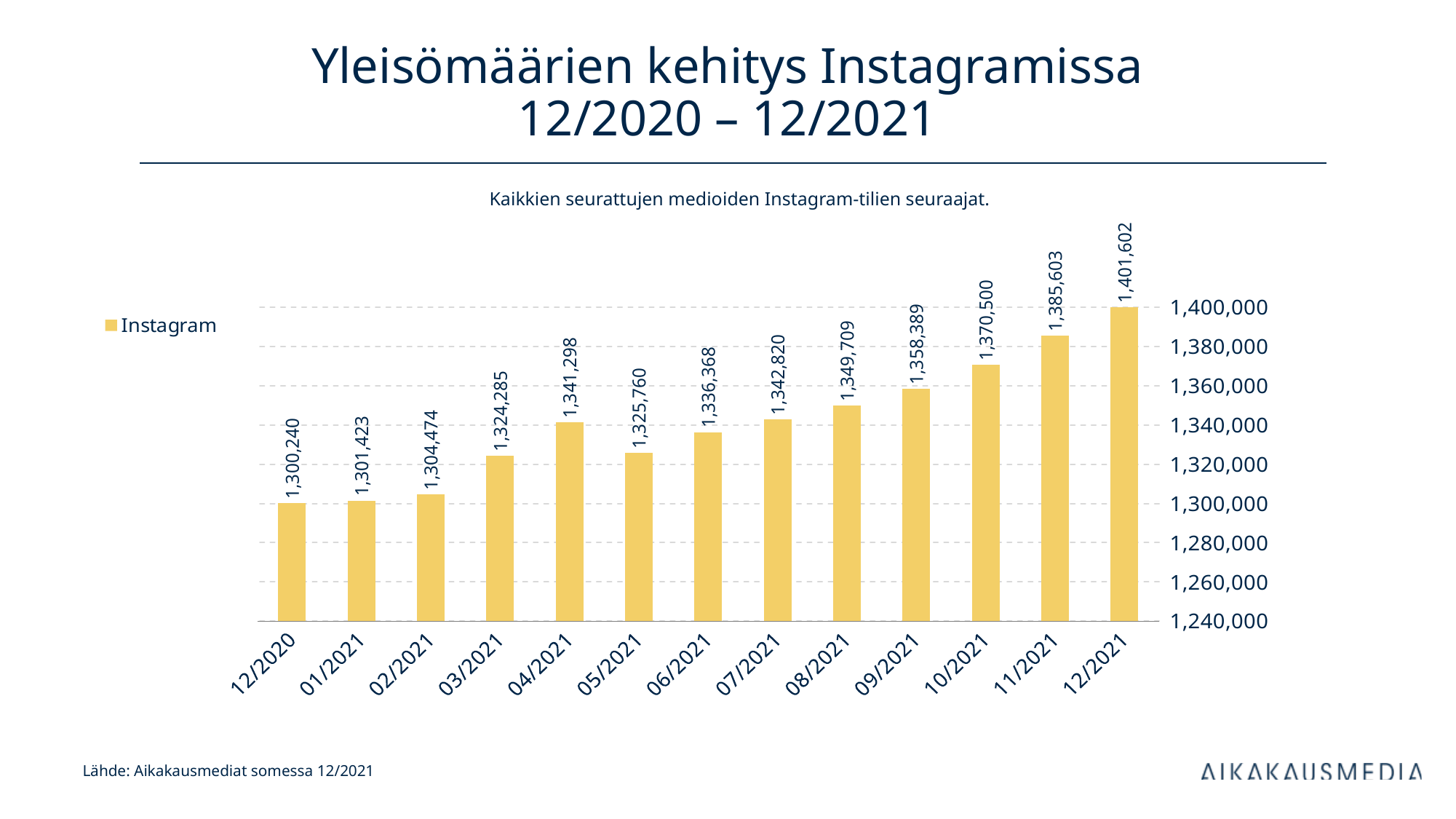
What kind of chart is shown on the slide? bar chart Is the value for 10/2021 greater or less than 1,360,000? greater Which month has the lowest value? 12/2020 How many months are shown on the x axis? 13 Which month has the highest value? 12/2021 What series does the legend list? Instagram What is the difference between the values for 04/2021 and 05/2021? 15,538 What is the value for 12/2020? 1,300,240 What is the value for 06/2021? 1,336,368 What is the difference between the values for 12/2021 and 12/2020? 101,362 Which is larger, the value for 04/2021 or the value for 05/2021? 04/2021 What is the value for 12/2021? 1,401,602